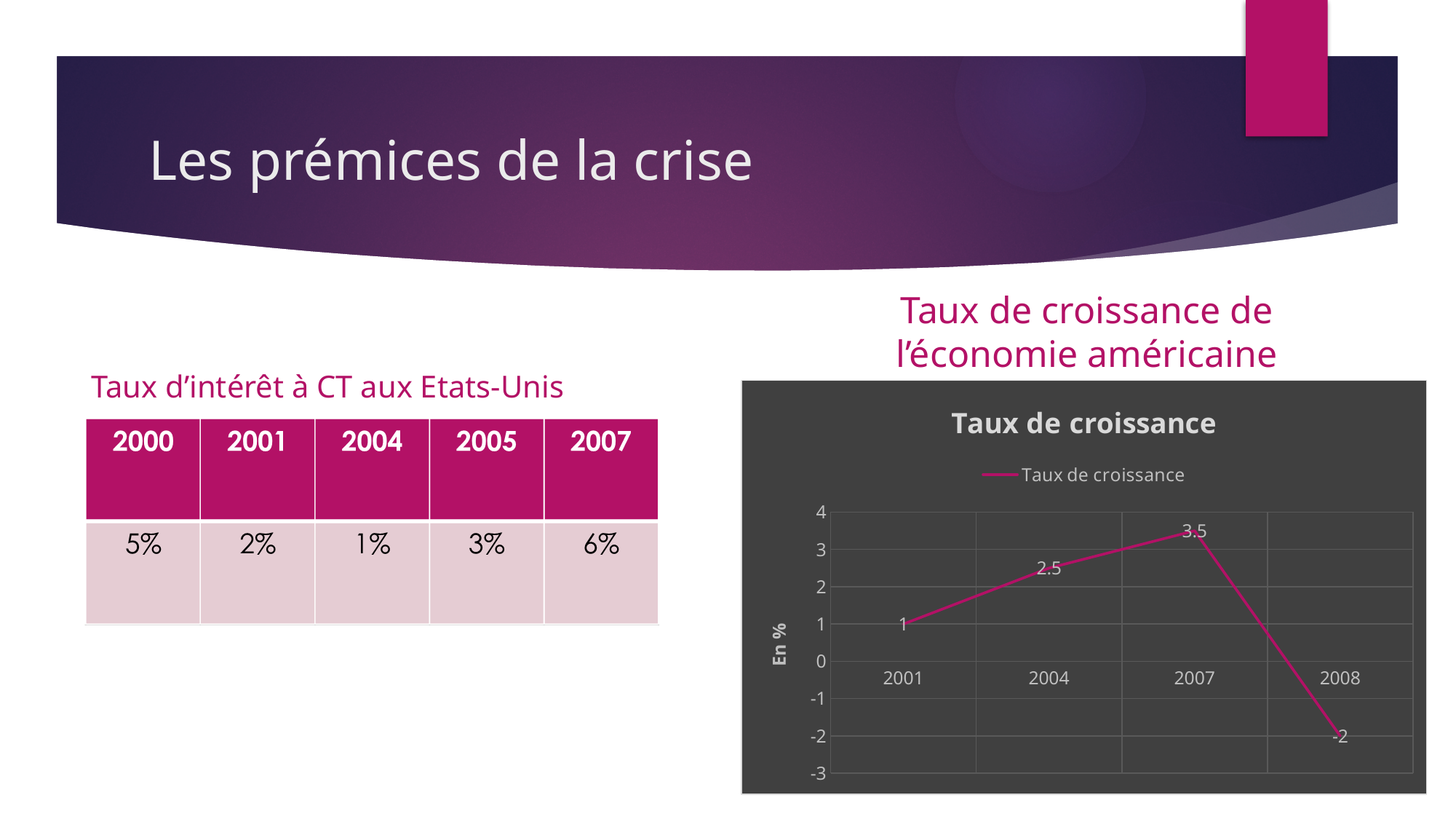
In the "Taux de croissance" chart, what is the value for 2001? 1 How many data points are plotted in the "Taux de croissance" chart? 4 In the "Taux de croissance" chart, which year has the lowest value? 2008 In the "Taux de croissance" chart, which year has the highest value? 2007 In the "Taux de croissance" chart, what is the value for 2007? 3.5 In the "Taux de croissance" chart, what is the value for 2004? 2.5 What type of chart is the "Taux de croissance" chart? line chart In the "Taux de croissance" chart, what is the difference between the values for 2007 and 2004? 1 In the "Taux de croissance" chart, which is larger, the value for 2001 or the value for 2004? 2004 In the "Taux de croissance" chart, what is the value for 2008? -2 What is the label of the vertical axis in the "Taux de croissance" chart? En % In the "Taux de croissance" chart, what is the difference between the values for 2007 and 2008? 5.5